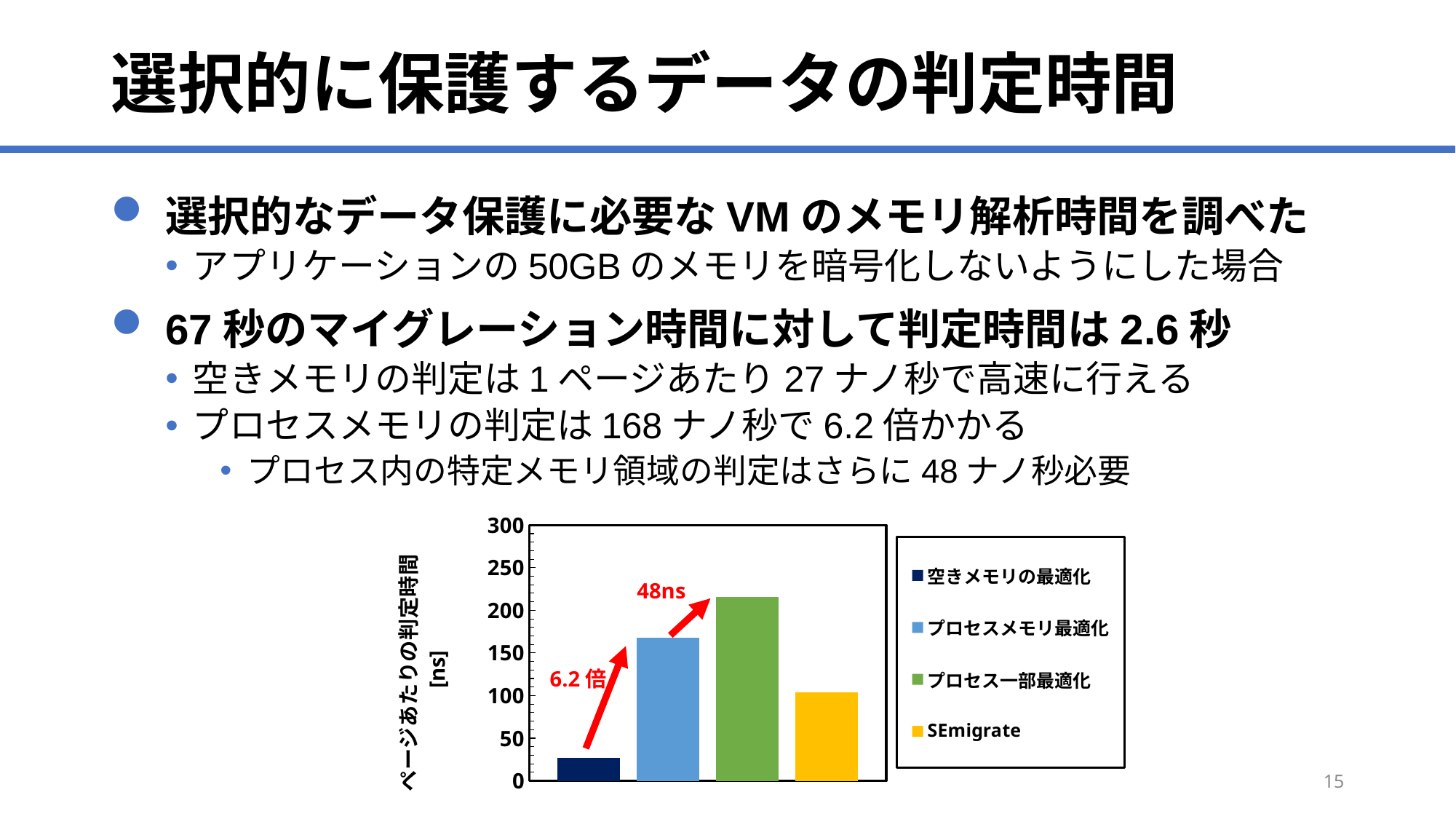
Which series has the lowest bar in the chart? 空きメモリの最適化 What annotation is written in red next to the arrow between the second and third bars? 48ns Is the value for プロセス一部最適化 greater or less than 200? greater Which series has the highest bar in the chart? プロセス一部最適化 What is the label of the vertical axis of the chart? ページあたりの判定時間 [ns] Is the value for 空きメモリの最適化 greater or less than 50? less How many series does the chart legend list? 4 Which is larger, the bar for SEmigrate or the bar for プロセスメモリ最適化? プロセスメモリ最適化 What kind of chart is shown on the slide? bar chart Is the value for SEmigrate greater or less than 150? less How many bars are plotted in the chart? 4